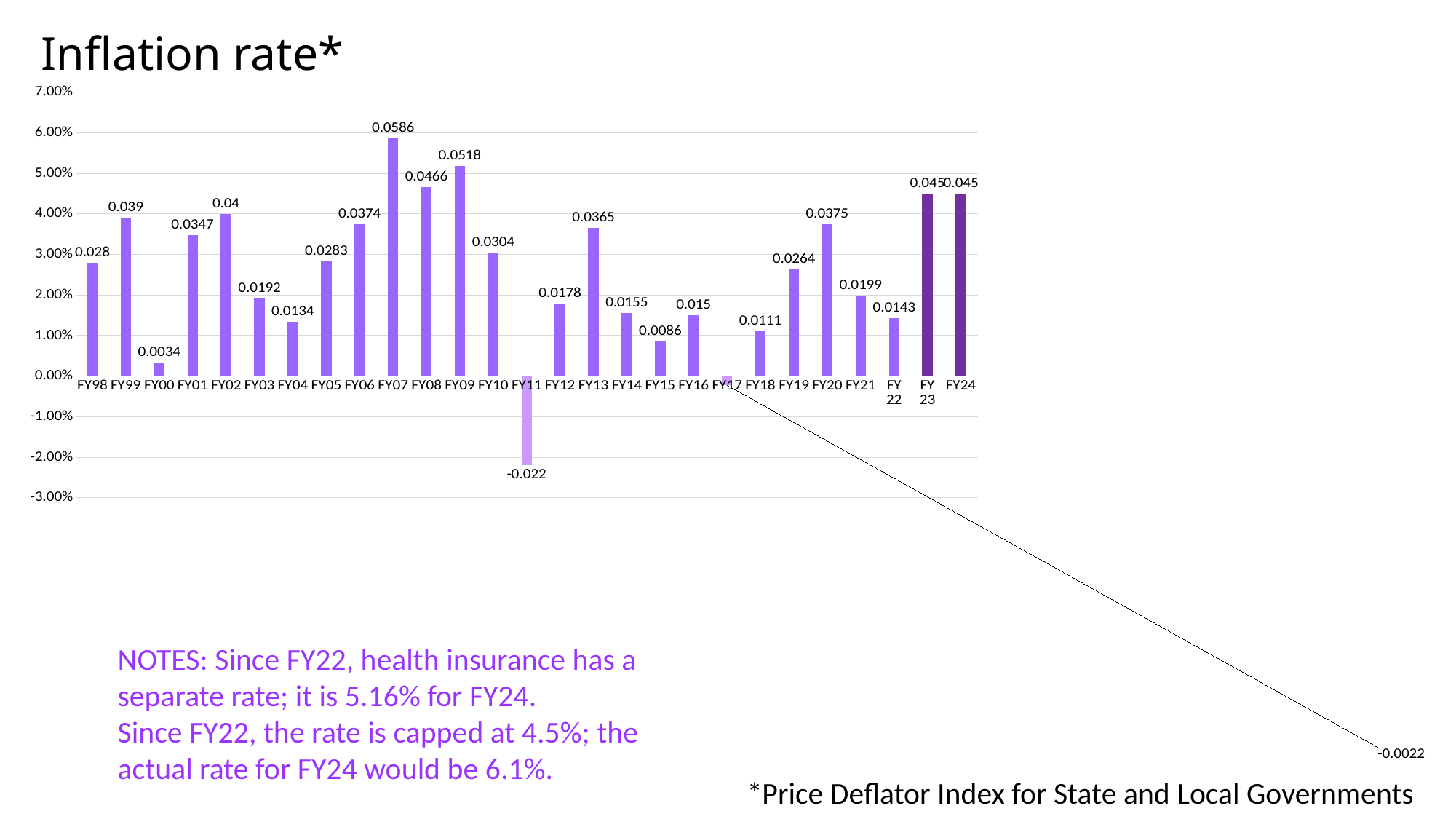
What is the inflation rate value shown for FY07? 0.0586 Which fiscal year has the highest inflation rate? FY07 What is the inflation rate value shown for FY11? -0.022 Do the values rise or fall from FY05 to FY07? Rise Which is larger, the value for FY13 or the value for FY19? FY13 How many fiscal years are plotted on the chart? 27 Which fiscal year has the lowest inflation rate? FY11 What is the inflation rate value shown for FY24? 0.045 What is the inflation rate value shown for FY17? -0.0022 Is the value for FY08 greater or less than 4.00%? greater What kind of chart is shown on the slide? Bar chart What is the difference between the values for FY07 and FY09? 0.0068